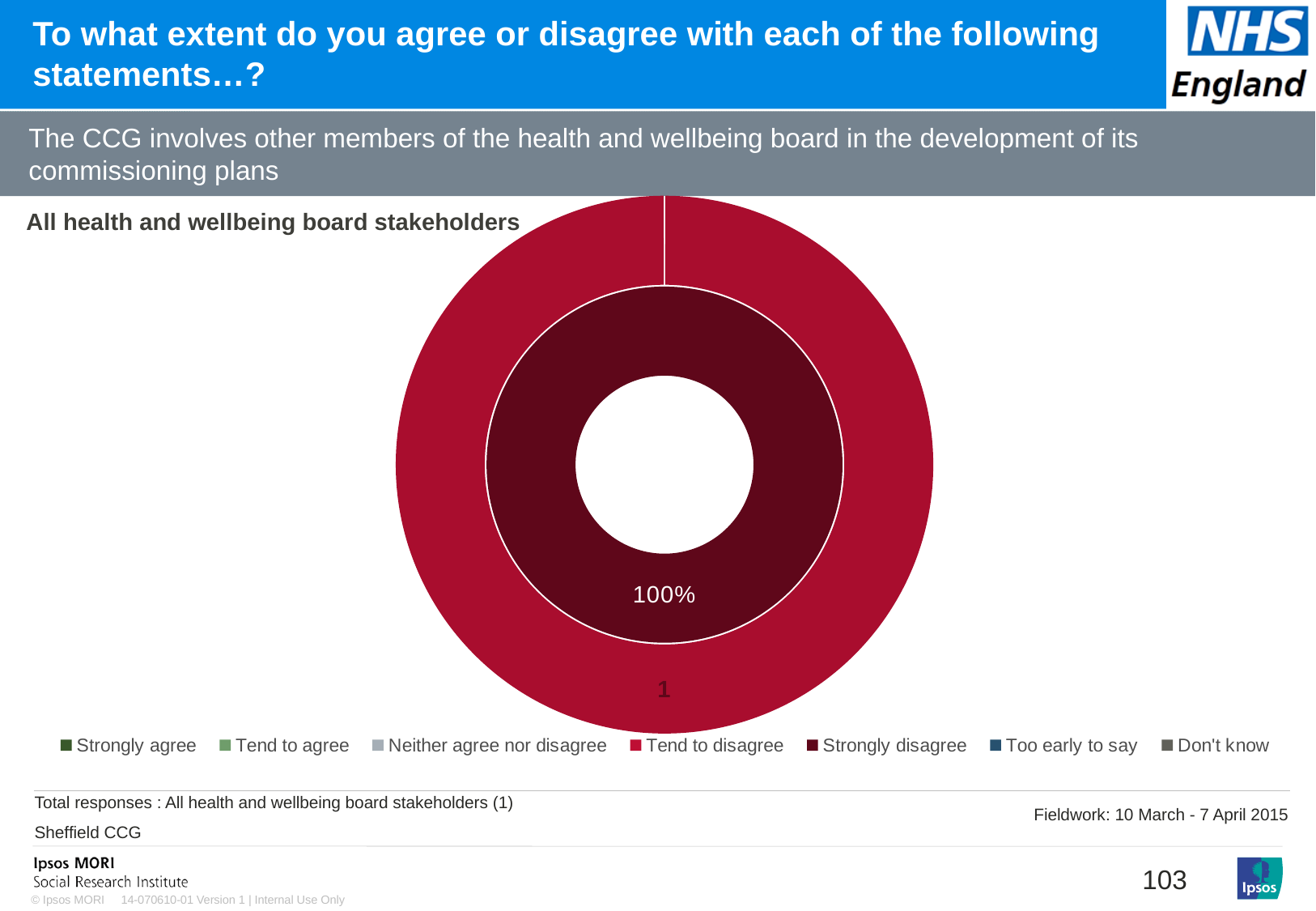
What kind of chart is shown on the slide? doughnut chart What is the last entry listed in the chart legend? Don't know What number is labelled on the outer ring of the doughnut chart? 1 Which legend entry matches the dark maroon colour of the inner ring that is labelled 100%? Strongly disagree Is the value labelled on the inner ring of the doughnut chart greater or less than 50%? greater How many entries does the chart legend list? 7 How many distinct segments are visible in the inner ring of the doughnut chart? 1 What is the first entry listed in the chart legend? Strongly agree What percentage value is labelled on the inner ring of the doughnut chart? 100%